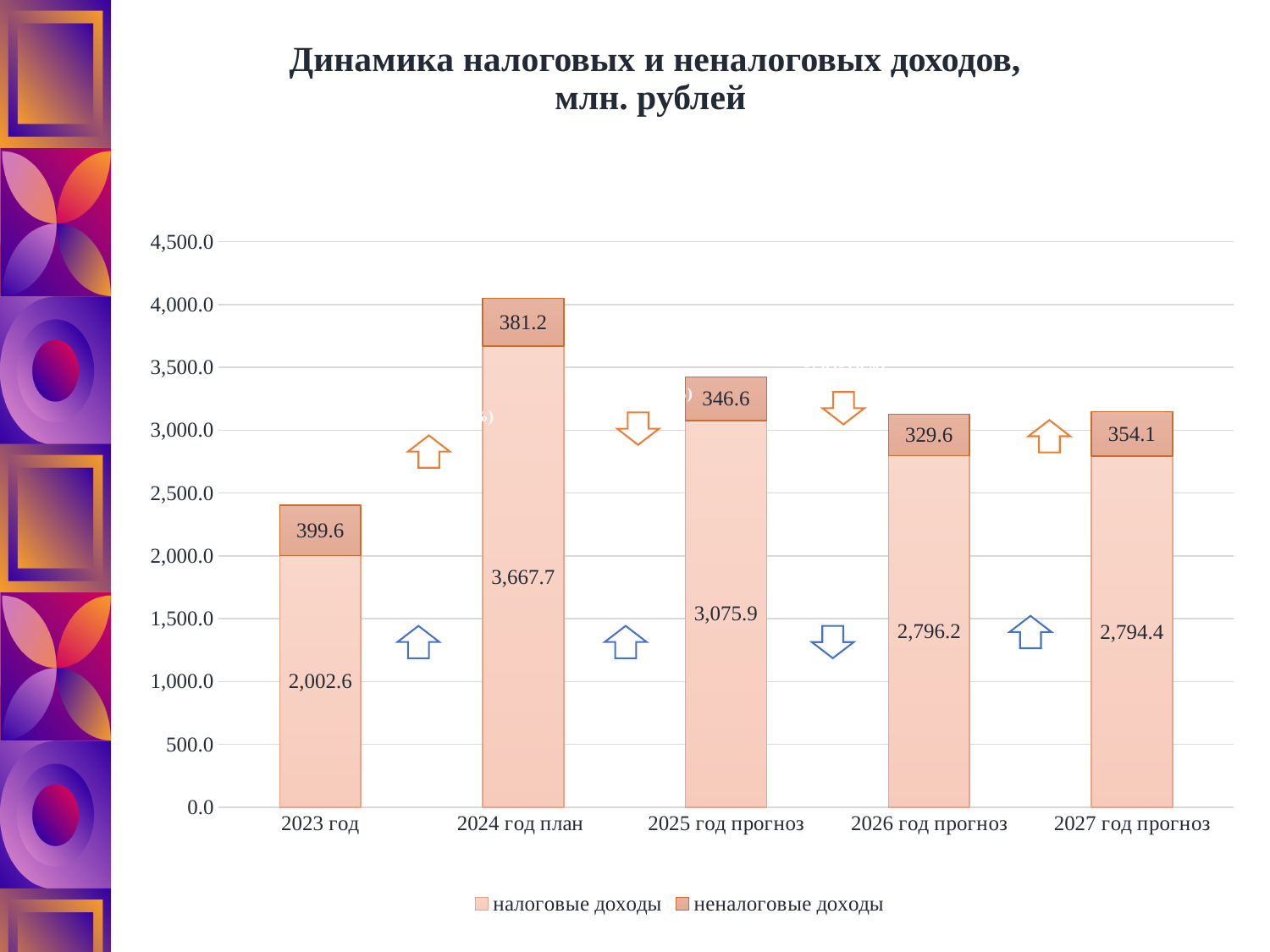
What kind of chart is shown on the slide? Stacked bar chart Which category has the highest value of налоговые доходы? 2024 год план Which is larger: неналоговые доходы in 2025 год прогноз or in 2027 год прогноз? 2027 год прогноз What is the value of неналоговые доходы for 2023 год? 399.6 Which category has the lowest value of неналоговые доходы? 2026 год прогноз What is the difference between налоговые доходы in 2024 год план and 2023 год? 1,665.1 What is the total of the stacked bar for 2026 год прогноз? 3,125.8 What is the value of налоговые доходы for 2024 год план? 3,667.7 What is the total of the stacked bar for 2023 год? 2,402.2 How many categories are shown on the x axis? 5 What is the value of налоговые доходы for 2027 год прогноз? 2,794.4 How many series does the legend list? 2